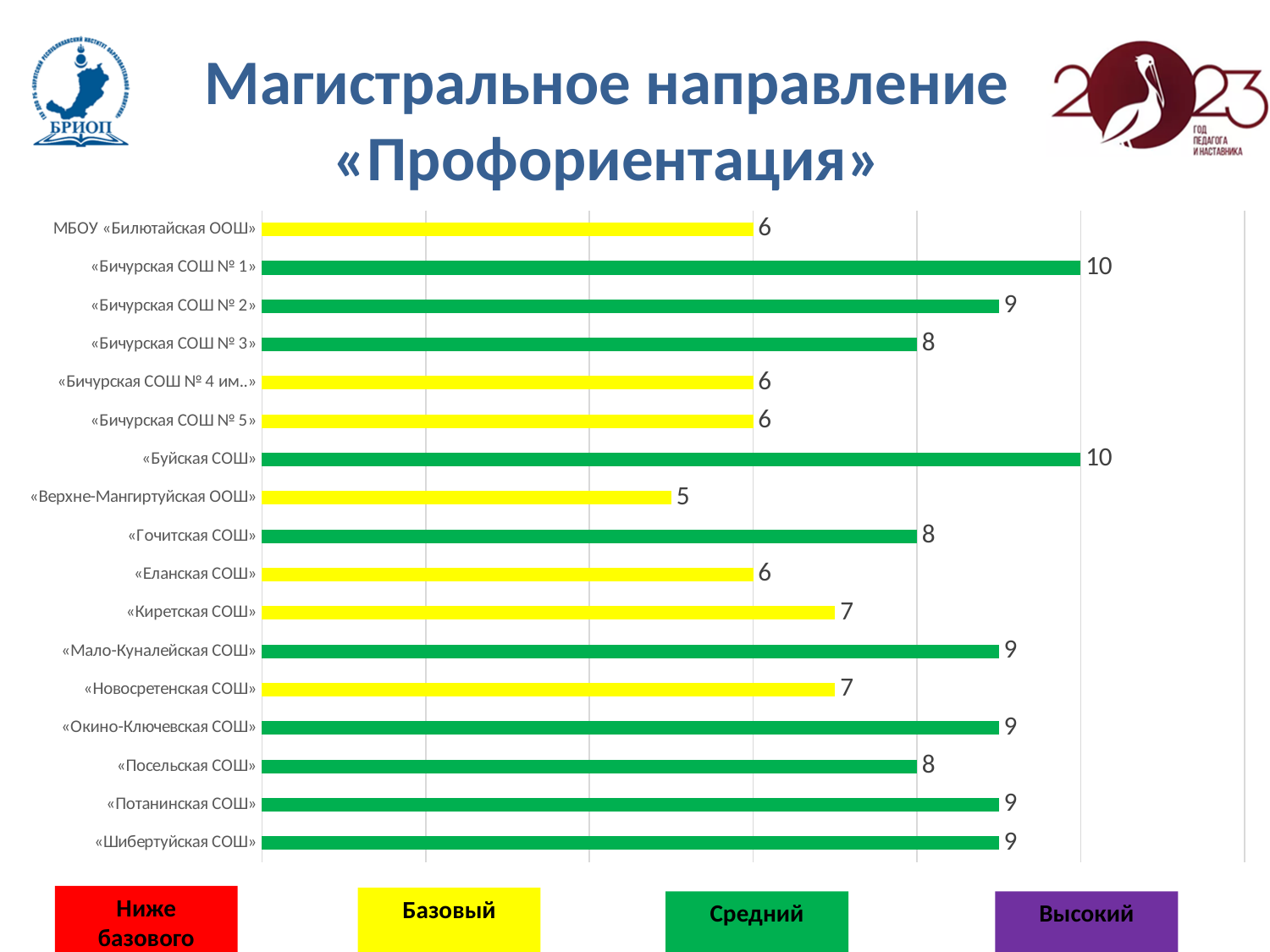
How many schools are shown in the chart? 17 What is the value for «Верхне-Мангиртуйская ООШ»? 5 Which school has the lowest value? «Верхне-Мангиртуйская ООШ» What is the value for «Посельская СОШ»? 8 What is the value for «Бичурская СОШ № 1»? 10 Which has a larger value, «Еланская СОШ» or «Шибертуйская СОШ»? «Шибертуйская СОШ» Which has a larger value, «Гочитская СОШ» or «Новосретенская СОШ»? «Гочитская СОШ» What is the difference between the values for «Бичурская СОШ № 2» and «Бичурская СОШ № 3»? 1 What is the difference between the values for «Буйская СОШ» and «Верхне-Мангиртуйская ООШ»? 5 What is the value for МБОУ «Билютайская ООШ»? 6 What is the value for «Киретская СОШ»? 7 What kind of chart is shown on the slide? Bar chart